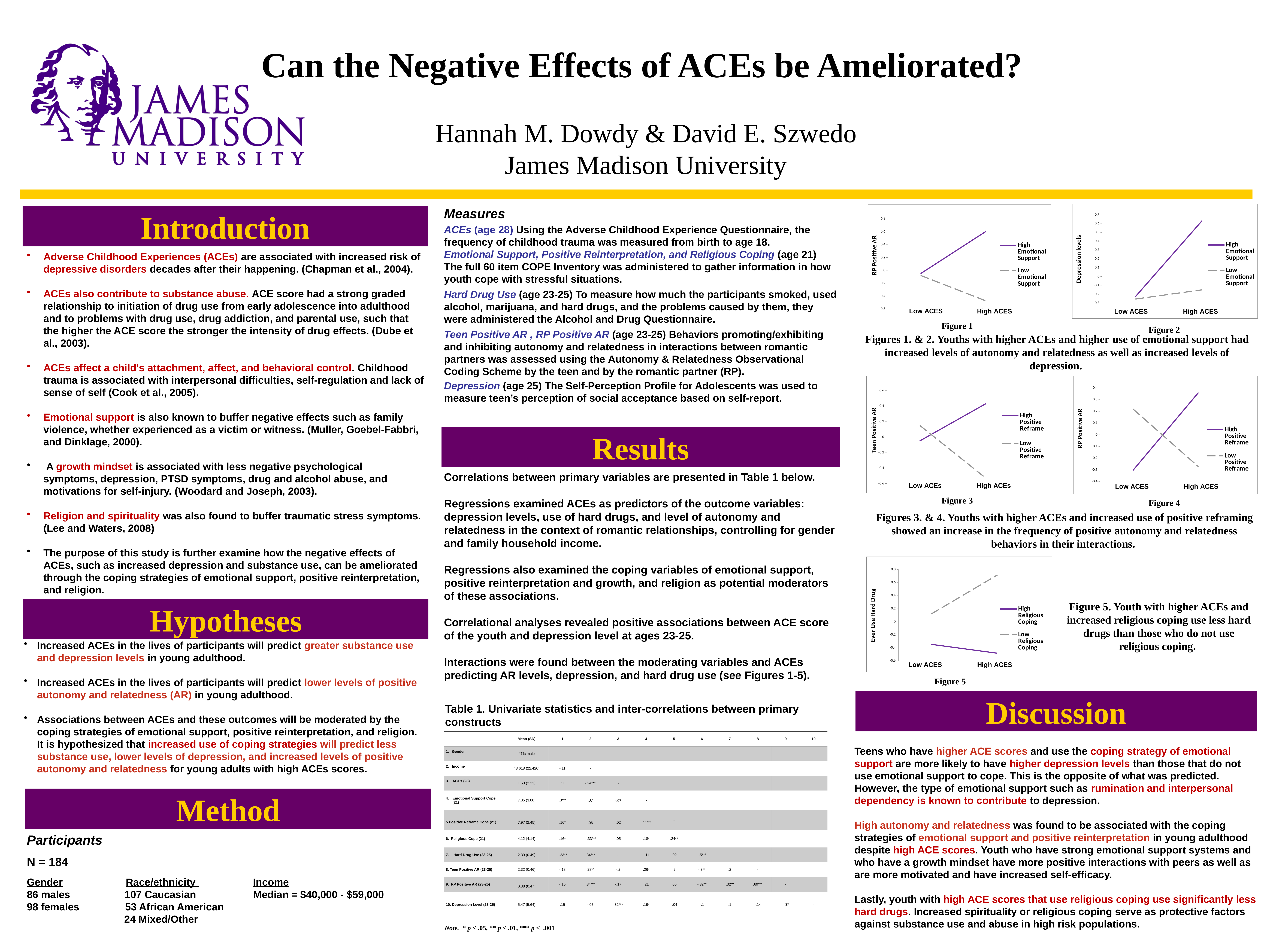
What is the y-axis title of Figure 5? Ever Use Hard Drug In Figure 2, at High ACES, which series has the higher depression level: High Emotional Support or Low Emotional Support? High Emotional Support In Figure 4, at High ACEs, which series is higher: High Positive Reframe or Low Positive Reframe? High Positive Reframe In Figure 2, does the High Emotional Support line rise or fall from Low ACES to High ACES? rise In Figure 1, does the High Emotional Support line rise or fall from Low ACES to High ACES? rise What type of chart is Figure 1? line chart In Figure 3, is the value for Low Positive Reframe at High ACEs greater or less than -0.2? less In Figure 3, does the Low Positive Reframe line rise or fall from Low ACEs to High ACEs? fall In Figure 1, how many categories are shown on the x axis? 2 In Figure 1, how many series does the legend list? 2 In Figure 1, is the value for High Emotional Support at High ACES greater or less than 0.4? greater In Figure 5, is the value for Low Religious Coping at High ACES greater or less than 0.4? greater